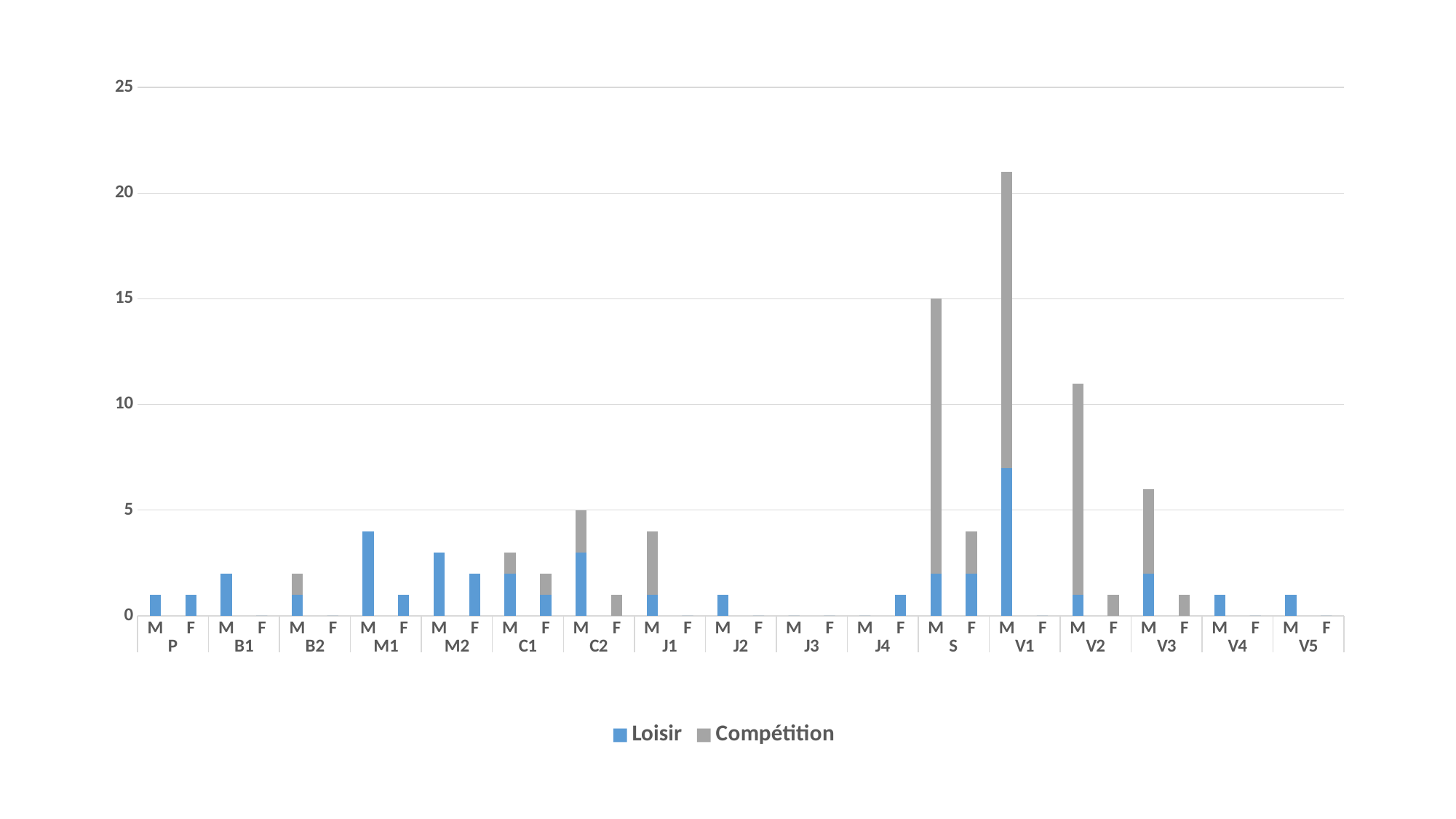
Is the total value for S M greater or less than 10? greater What kind of chart is shown on the slide? Stacked bar chart Is the total value for M1 M greater or less than 5? less What are the two series named in the legend? Loisir and Compétition Which age-category group has no bars at all for either M or F? J3 Which bar is the tallest on the chart? V1 M Which is larger, the total bar for V1 M or the total bar for S M? V1 M Is the total value for V1 M greater or less than 20? greater Which colour represents the Compétition series? Grey Which is larger, the total bar for S M or the total bar for V2 M? S M How many series does the legend list? 2 How many age-category groups (P, B1, B2, ...) are shown along the x axis? 17